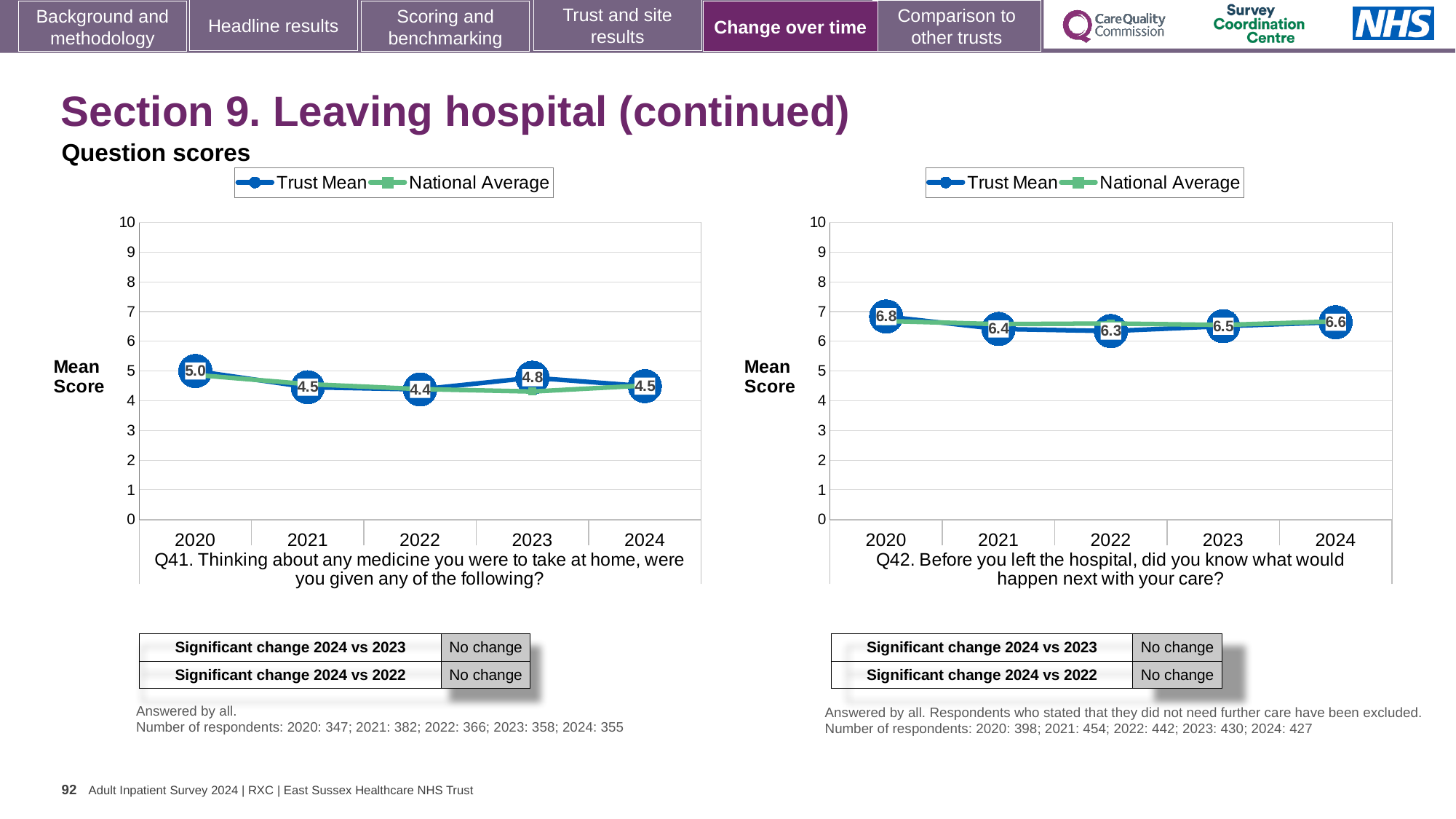
How many years are shown on the x axis of the Q41 chart? 5 What kind of chart is the Q41 chart? Line chart In the Q41 chart, what is the Trust Mean score for 2020? 5.0 In the Q42 chart, which year has the highest Trust Mean score? 2020 In the Q42 chart, does the Trust Mean score rise or fall from 2020 to 2022? Fall In the Q41 chart, is the Trust Mean score higher in 2020 or in 2024? 2020 In the Q42 chart, what is the difference between the Trust Mean scores for 2020 and 2022? 0.5 In the Q41 chart, what is the Trust Mean score for 2023? 4.8 In the Q41 chart, which year has the lowest Trust Mean score? 2022 In the Q42 chart, what is the Trust Mean score for 2024? 6.6 How many series does the legend of the Q42 chart list? 2 In the Q42 chart, is the National Average value for 2021 greater or less than 7? less